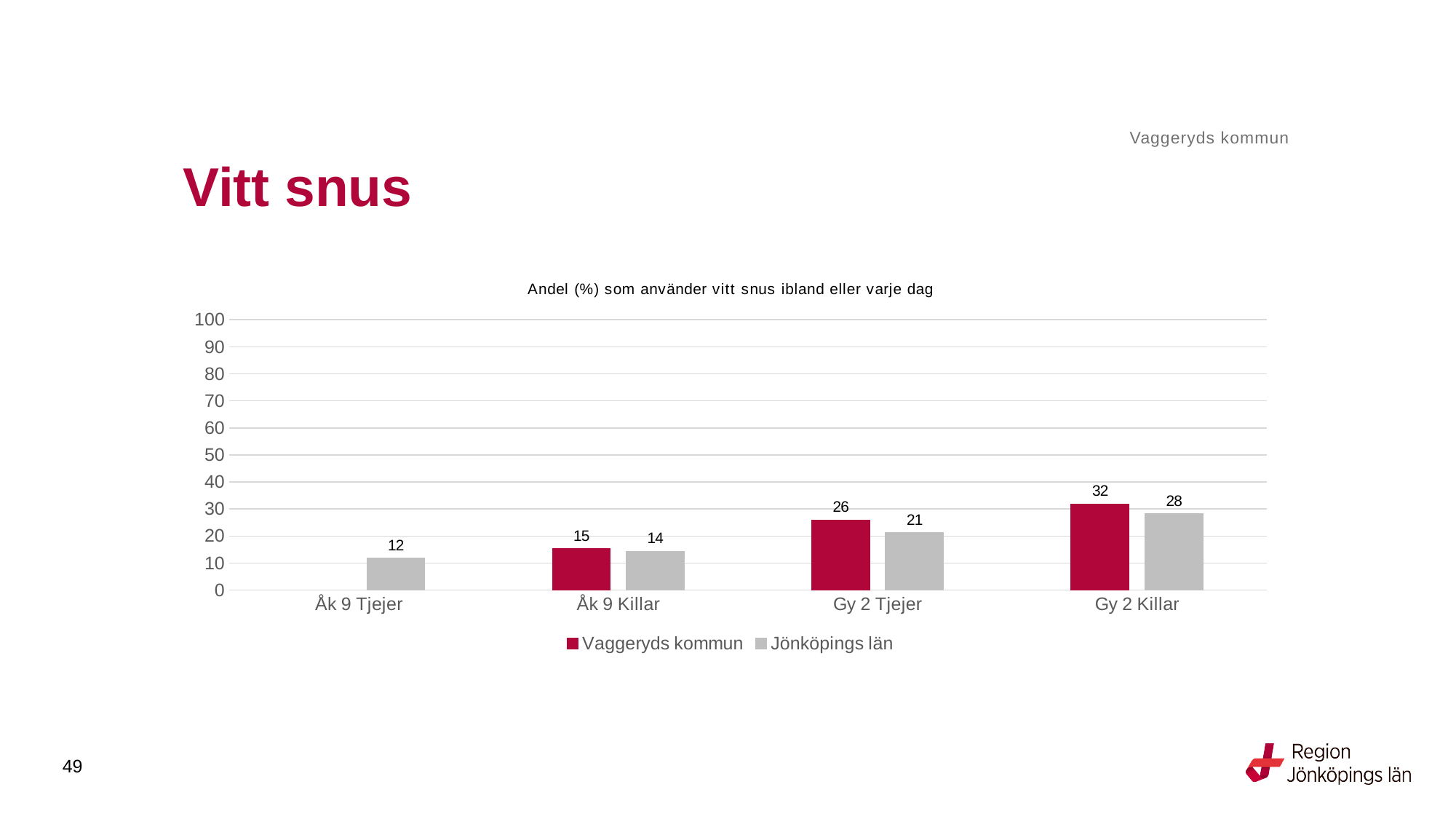
Which category has the lowest value for Jönköpings län? Åk 9 Tjejer How many series does the legend list? 2 What kind of chart is shown on the slide? Bar chart What is the title of the chart? Andel (%) som använder vitt snus ibland eller varje dag What is the value for Jönköpings län for Åk 9 Killar? 14 Which category has the highest value for Jönköpings län? Gy 2 Killar Which is larger for Gy 2 Killar: Vaggeryds kommun or Jönköpings län? Vaggeryds kommun What is the difference between Vaggeryds kommun and Jönköpings län for Gy 2 Tjejer? 5 What is the value for Vaggeryds kommun for Gy 2 Killar? 32 What is the value for Jönköpings län for Åk 9 Tjejer? 12 What is the value for Vaggeryds kommun for Gy 2 Tjejer? 26 How many categories are shown on the x axis? 4